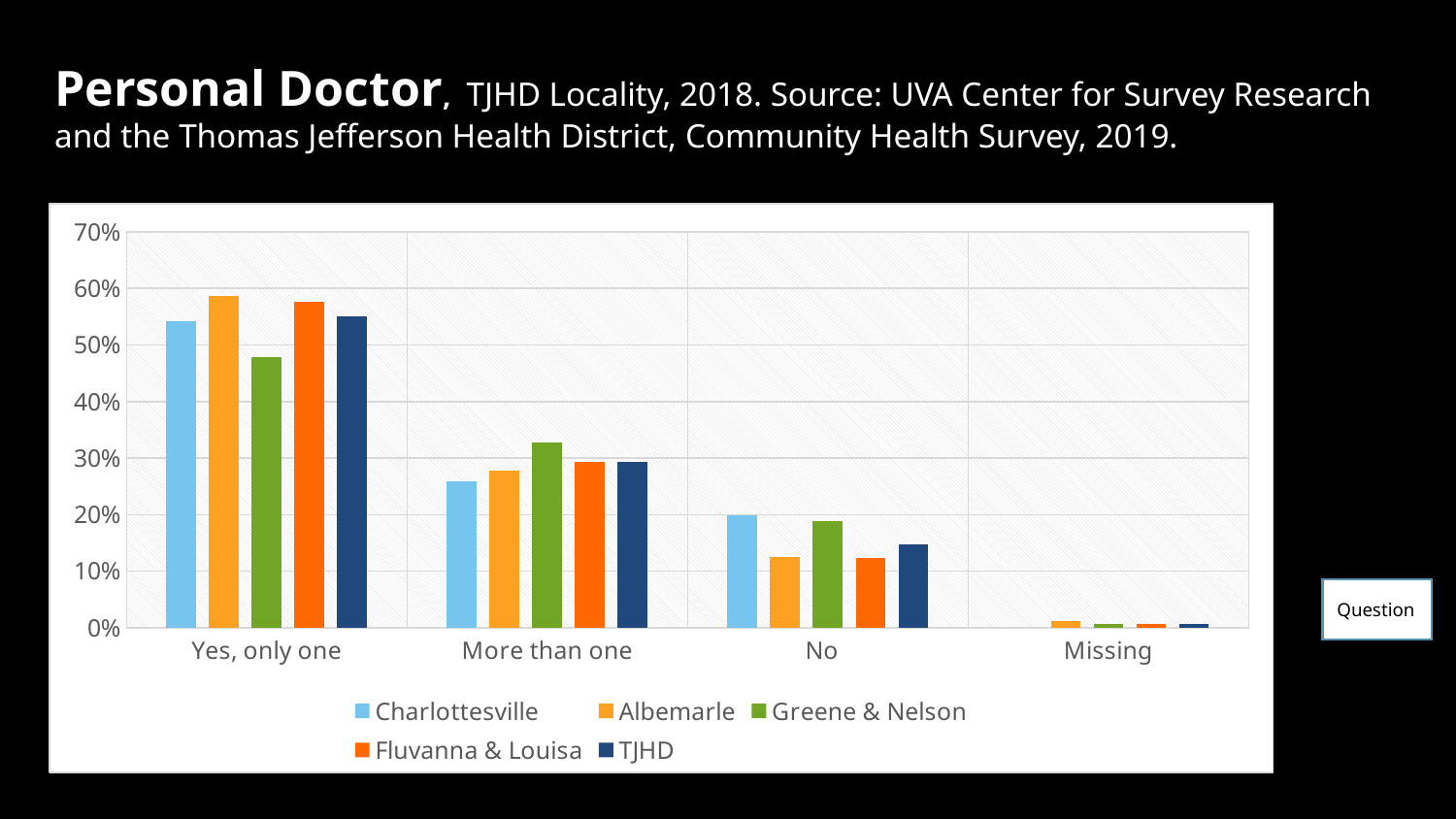
How many response categories are shown on the x axis? 4 In the 'Yes, only one' category, which locality has the lowest value? Greene & Nelson Do the values for Charlottesville rise or fall moving from 'Yes, only one' to 'Missing' along the x axis? fall In the 'No' category, which is larger: Charlottesville or Albemarle? Charlottesville Is the value for Greene & Nelson in the 'More than one' category greater or less than 30%? greater How many localities (series) does the legend list? 5 Is the value for Greene & Nelson in the 'Yes, only one' category greater or less than 50%? less Is the value for Charlottesville in the 'More than one' category greater or less than 30%? less What kind of chart is shown on the slide? Bar chart In the 'More than one' category, which locality has the highest value? Greene & Nelson What colour represents TJHD in the legend? Dark blue